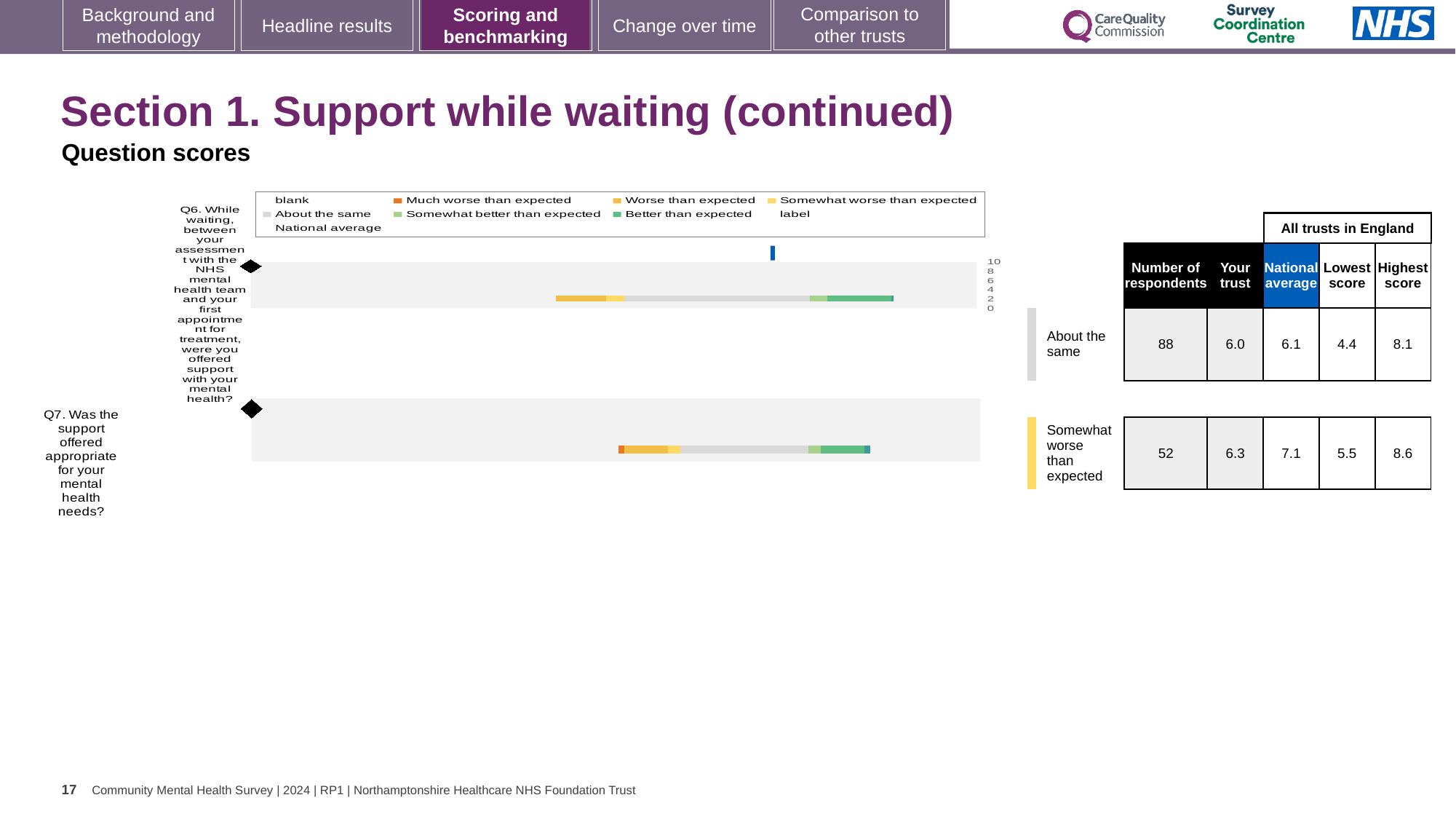
Which benchmark category is shown for Q7 (support appropriate for mental health needs)? Somewhat worse than expected What is the difference between the highest score and the lowest score for Q7? 3.1 What kind of chart is shown on the slide? bar chart How many questions (bars) are plotted in the chart? 2 Which question is plotted in the top bar of the chart? Q6 What is the highest value shown on the chart's score axis? 10 Which question has the larger number of respondents, Q6 or Q7? Q6 Which benchmark category is shown for Q6 (support while waiting)? About the same What is the national average score for Q7? 7.1 What is the 'Your trust' score for Q6? 6.0 For Q7, which is larger: the 'Your trust' score or the national average? National average How many respondents are listed for Q6? 88